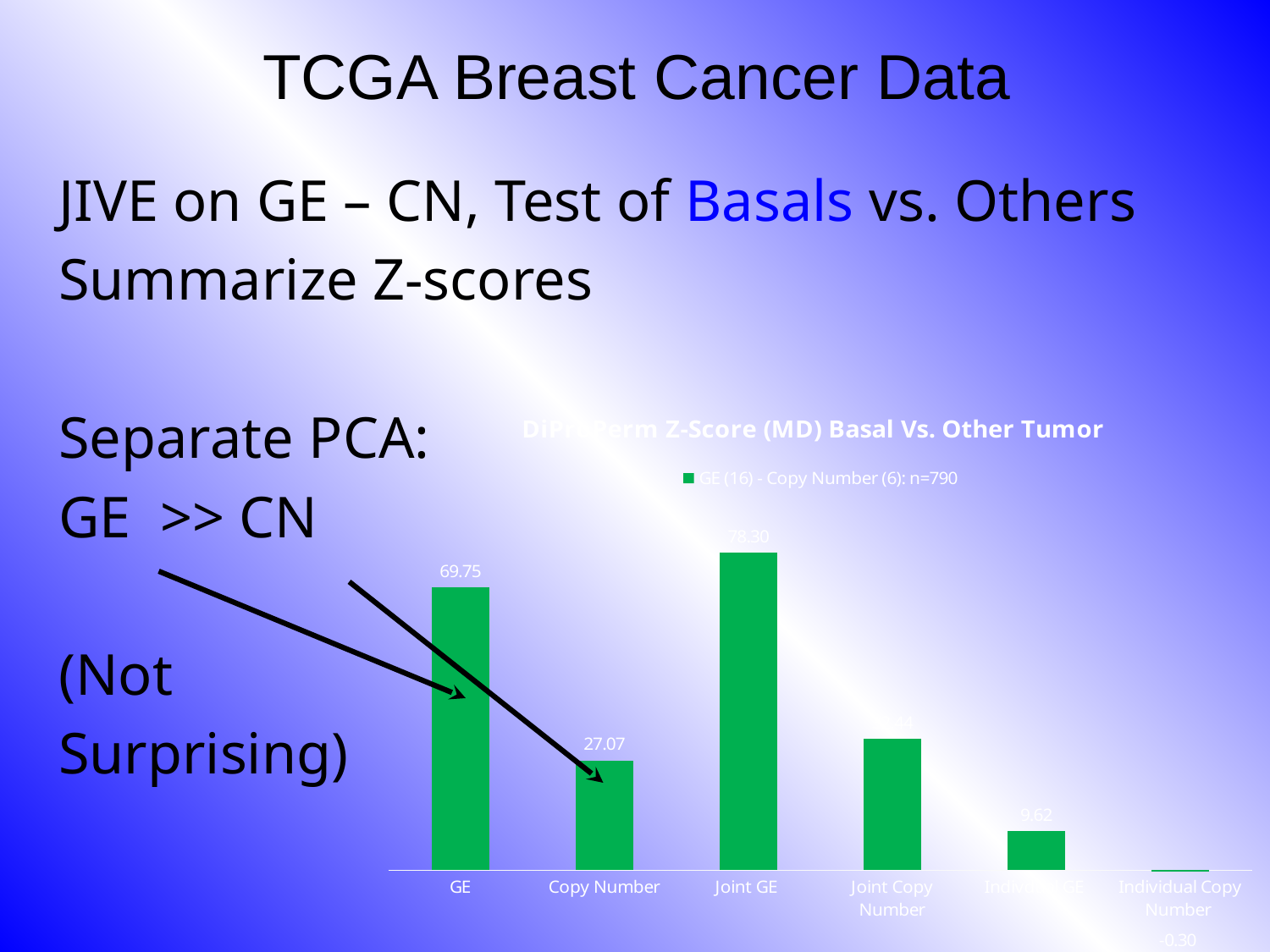
What is the value for Copy Number? 27.07 What is the difference between the values for GE and Copy Number? 42.68 What is the value for Individual Copy Number? -0.30 What is the value for GE? 69.75 Which category has the lowest value? Individual Copy Number What is the legend entry for the series shown in the chart? GE (16) - Copy Number (6): n=790 What is the value for Individual GE? 9.62 Which is larger, the value for GE or the value for Joint GE? Joint GE What kind of chart is shown on the slide? Bar chart Which category has the highest value? Joint GE How many categories are shown on the x axis? 6 What is the value for Joint GE? 78.30